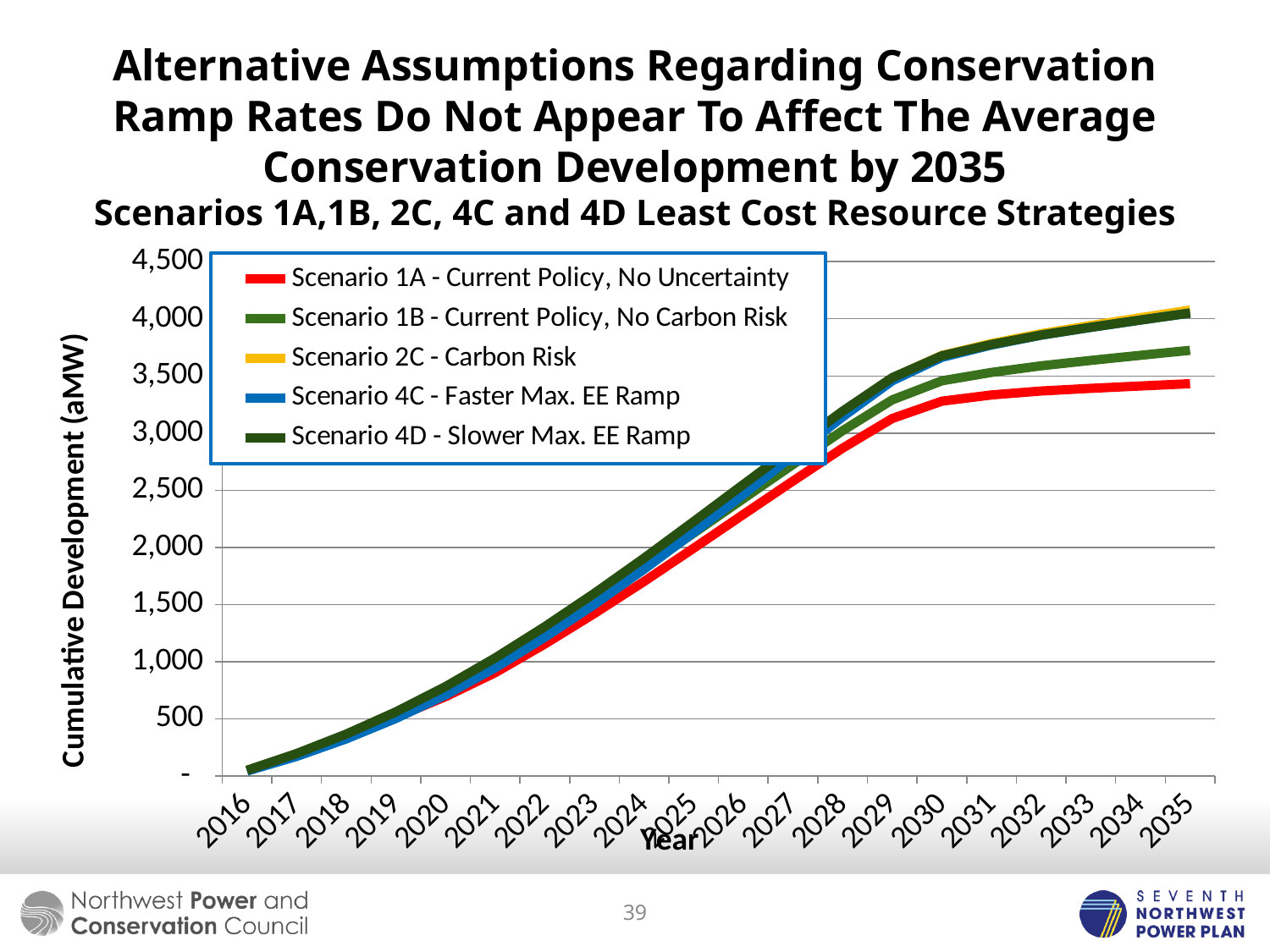
What kind of chart is shown on the slide? line chart What colour is the line for Scenario 1A - Current Policy, No Uncertainty? red Is the value for Scenario 1A in 2020 greater or less than 1,000? less Do the values for Scenario 1A rise or fall from 2016 to 2035? rise How many years are shown along the x axis? 20 How many series does the legend list? 5 What is the label of the y axis? Cumulative Development (aMW) Is the value for Scenario 4D in 2035 greater or less than 3,500? greater Is the value for Scenario 1A in 2030 greater or less than 3,000? greater Which scenario has the lowest cumulative development in 2035? Scenario 1A - Current Policy, No Uncertainty In 2035, which is larger: the value for Scenario 1A or the value for Scenario 1B? Scenario 1B